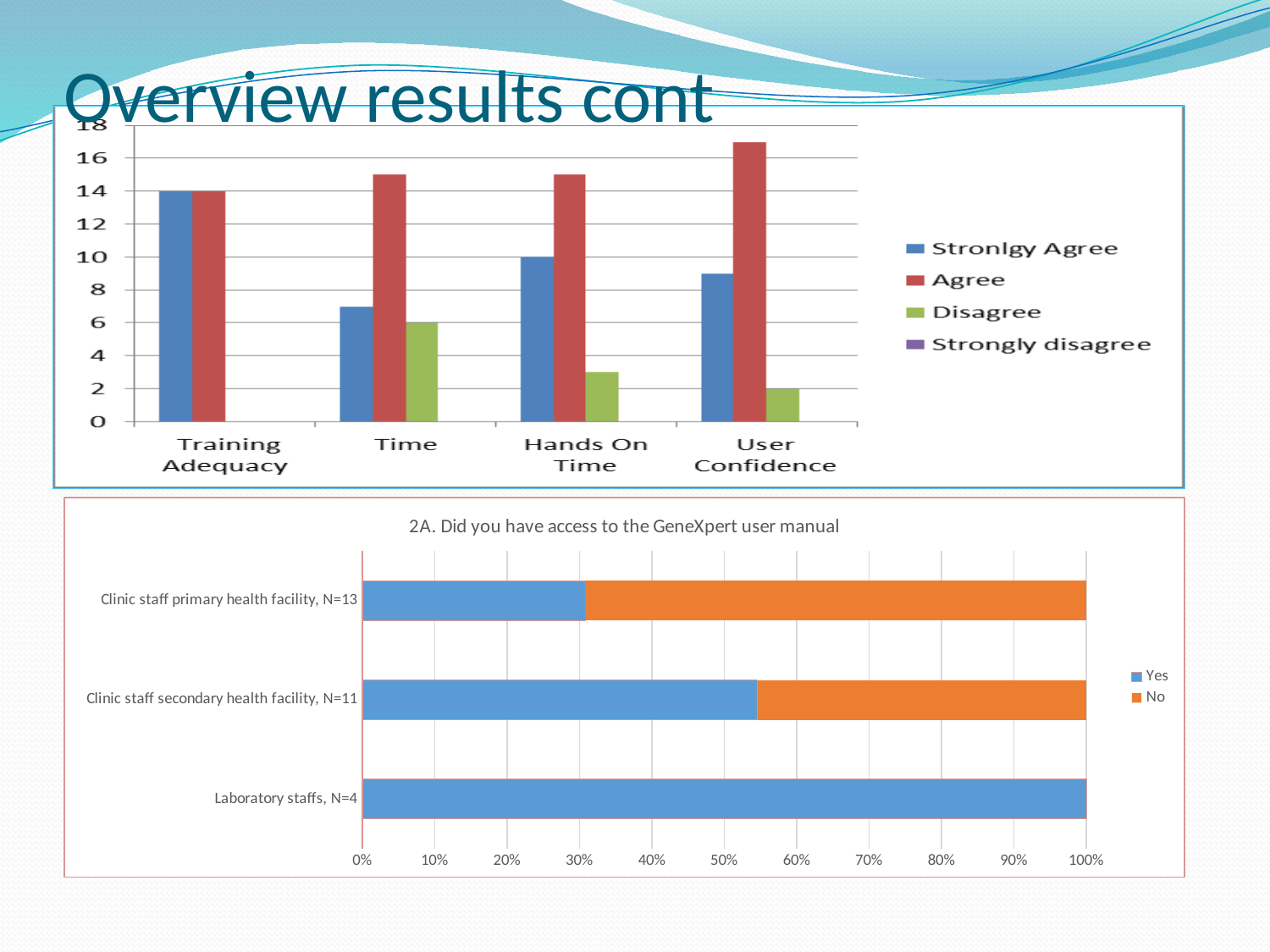
In the top chart, what is the value of Disagree for Time? 6 In the top chart, which is larger for Time: Stronlgy Agree or Agree? Agree How many series does the legend of the top chart list? 4 In the top chart, is the Agree value for User Confidence greater or less than 16? greater How many categories are shown on the x axis of the top chart? 4 In the chart titled '2A. Did you have access to the GeneXpert user manual', is the Yes share for Clinic staff primary health facility, N=13 greater or less than 40%? less In the chart titled '2A. Did you have access to the GeneXpert user manual', which group has the lowest Yes share? Clinic staff primary health facility, N=13 What kind of chart is the top chart on the slide? bar chart In the top chart, what is the value of Stronlgy Agree for Hands On Time? 10 In the top chart, what is the value of Stronlgy Agree for Training Adequacy? 14 In the top chart, which category has the highest Agree value? User Confidence In the chart titled '2A. Did you have access to the GeneXpert user manual', what is the Yes share for Laboratory staffs, N=4? 100%